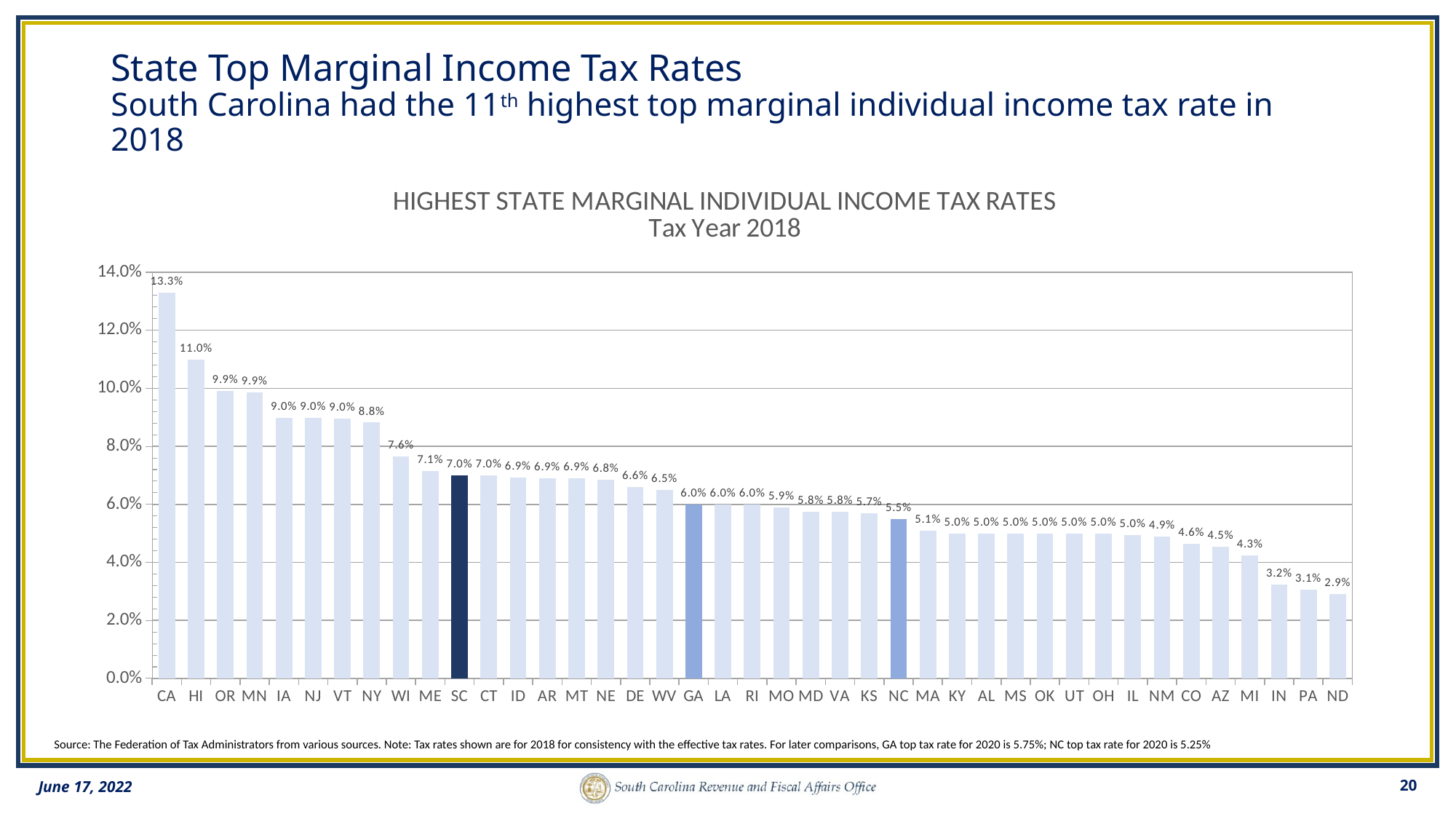
Which state has the highest top marginal income tax rate on the chart? CA Which state has the lowest top marginal income tax rate on the chart? ND Is the value for HI greater or less than 10.0%? greater What is the difference between the rates for CA and HI? 2.3% What is the difference between the rates for SC and NC? 1.5% Do the values rise or fall moving from left to right along the x axis? Fall What is the top marginal income tax rate shown for SC? 7.0% Which state has a higher top marginal rate, NY or WI? NY What kind of chart is shown on the slide? Bar chart What is the top marginal income tax rate shown for NC? 5.5% How many states are shown on the chart? 41 What is the top marginal income tax rate shown for GA? 6.0%